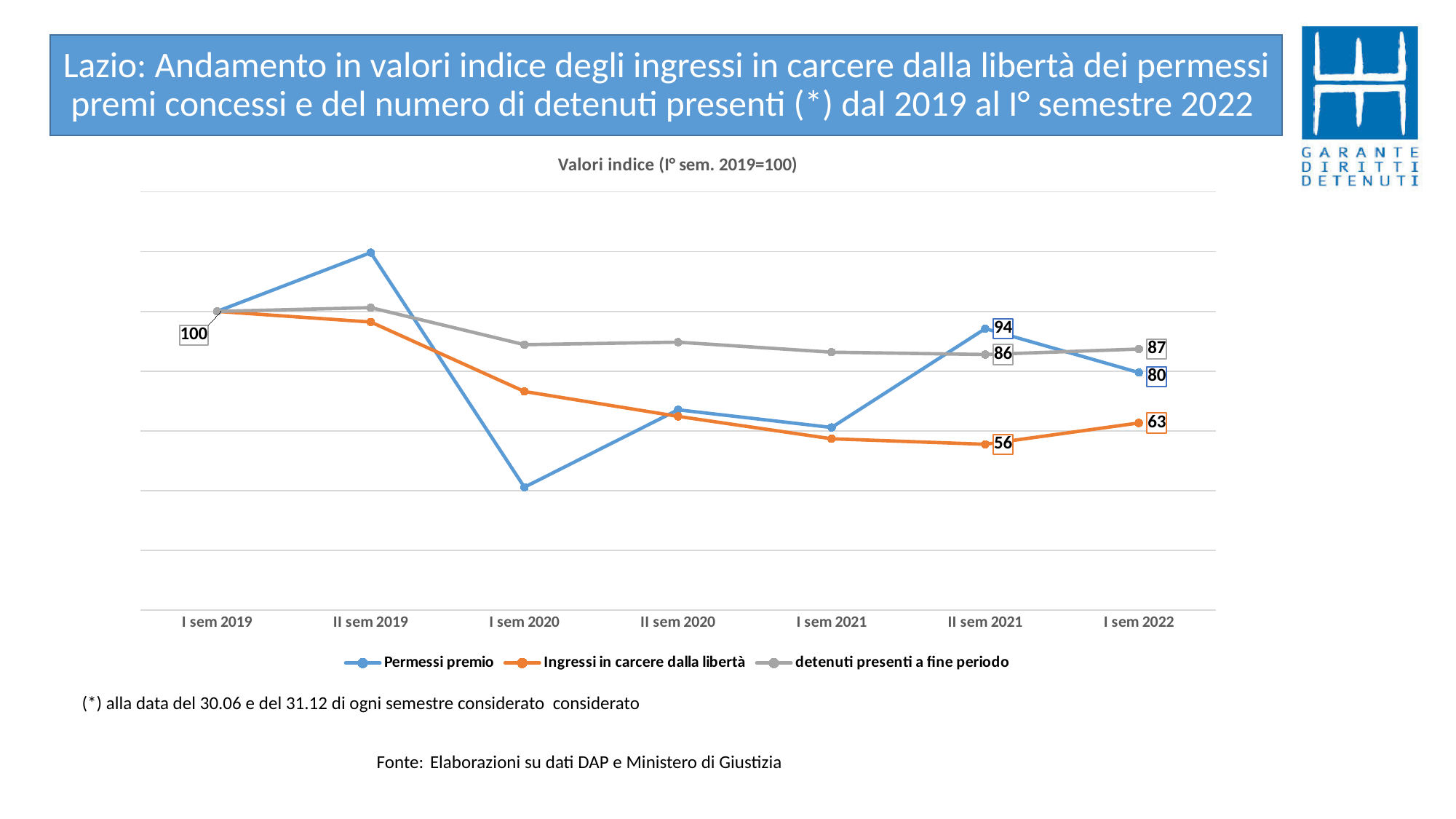
What kind of chart is shown on the slide? line chart What is the value of Ingressi in carcere dalla libertà in II sem 2021? 56 How many periods are shown on the x axis? 7 What is the value of detenuti presenti a fine periodo in I sem 2022? 87 By how much did Ingressi in carcere dalla libertà change from II sem 2021 (56) to I sem 2022 (63)? 7 What is the difference between the Permessi premio values in II sem 2021 and I sem 2022? 14 What is the value of Permessi premio in I sem 2022? 80 In which period does Permessi premio reach its highest value? II sem 2019 How many series does the legend list? 3 What is the title printed above the chart? Valori indice (I° sem. 2019=100) In I sem 2022, which is larger: Permessi premio or detenuti presenti a fine periodo? detenuti presenti a fine periodo What is the value of Permessi premio in II sem 2021? 94